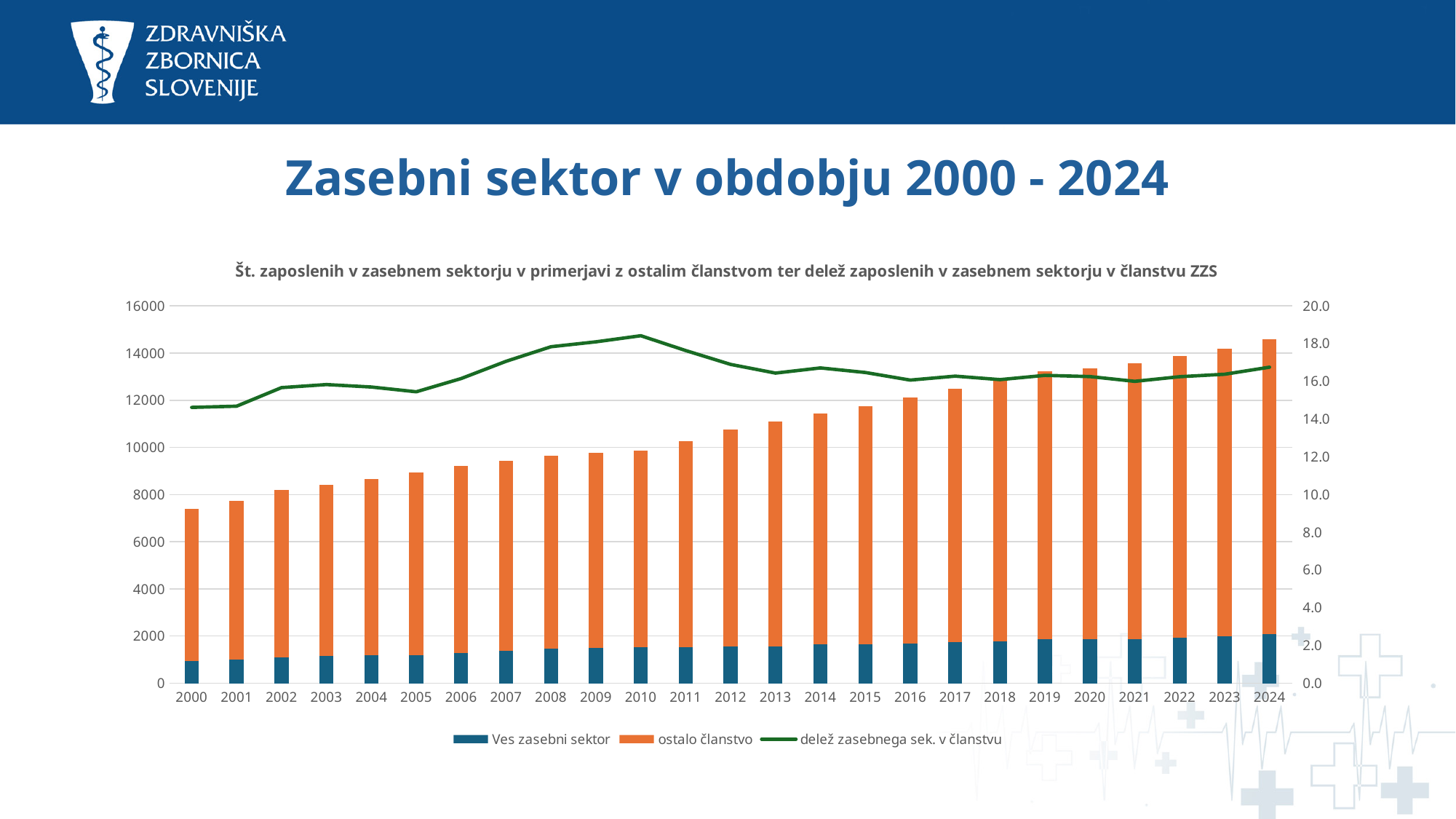
In which year does the line 'delež zasebnega sek. v članstvu' reach its highest point? 2010 Which year has the tallest stacked bar? 2024 What kind of chart is shown on the slide? A stacked bar chart combined with a line chart How many years are shown on the x axis? 25 Is the total of the stacked bar for 2000 greater or less than 8000? less Is the value of the line 'delež zasebnega sek. v članstvu' in 2000 greater or less than 16.0 on the right axis? less What colour are the bars for the series 'Ves zasebni sektor'? Blue How many series does the legend list? 3 Do the stacked bar totals rise or fall from 2000 to 2024? rise Is the total of the stacked bar for 2024 greater or less than 14000? greater Which year has the shortest stacked bar? 2000 Which is higher on the line 'delež zasebnega sek. v članstvu': 2010 or 2013? 2010